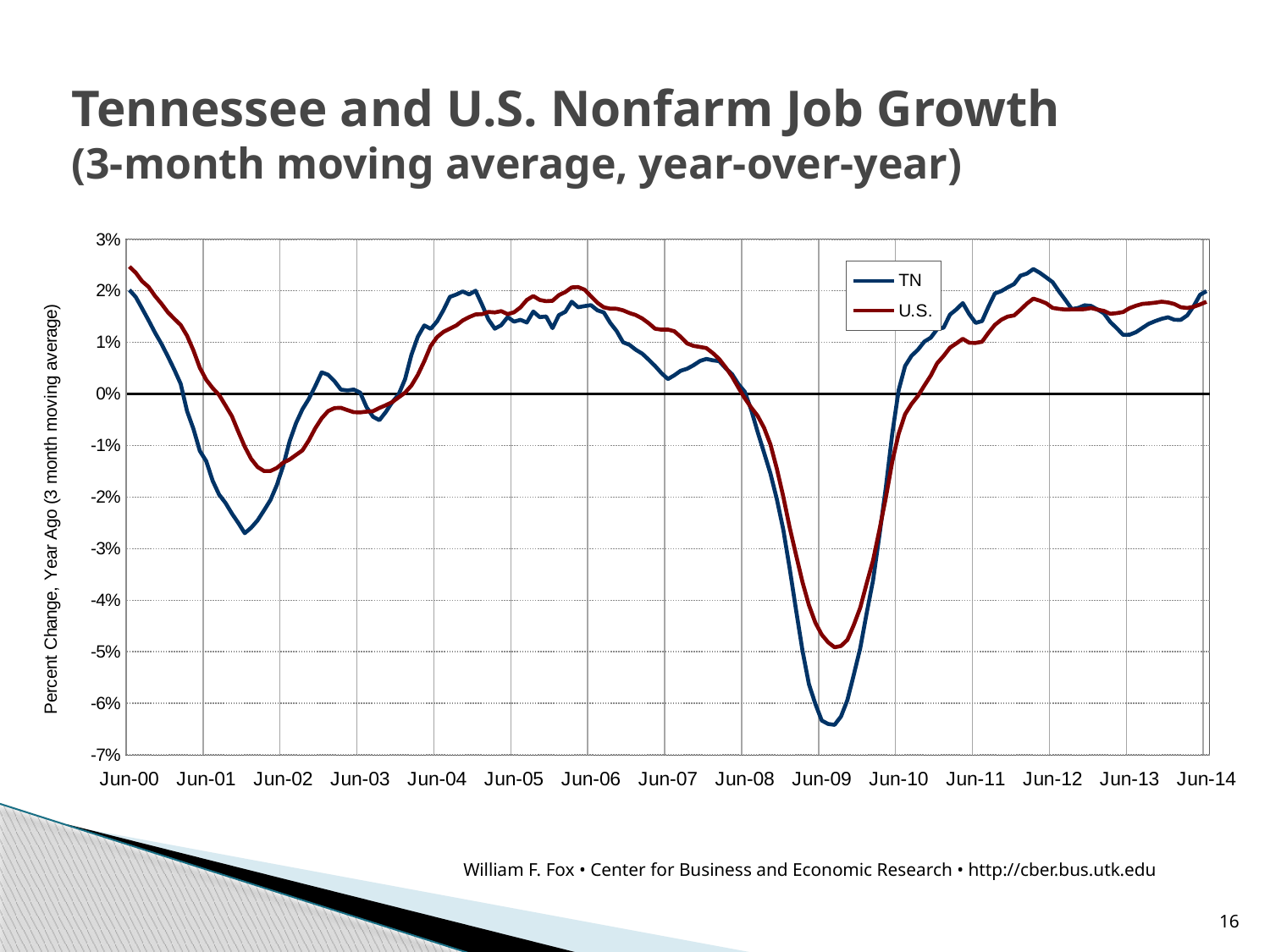
Is the value for TN at Jun-09 greater or less than -5%? less Is the value for U.S. at Jun-00 greater or less than 2%? greater How many series does the legend list? 2 Which series reaches the lowest value on the chart? TN What kind of chart is shown on the slide? line chart Is the value for U.S. at Jun-09 greater or less than -6%? greater Which series is drawn in red? U.S. Between Jun-08 and Jun-09, does the TN series rise or fall? fall Near which x-axis label does the TN series reach its lowest point? Jun-09 At Jun-01, which series has the higher value, TN or U.S.? U.S. At Jun-13, which series has the higher value, TN or U.S.? U.S. What are the two series named in the legend? TN and U.S.